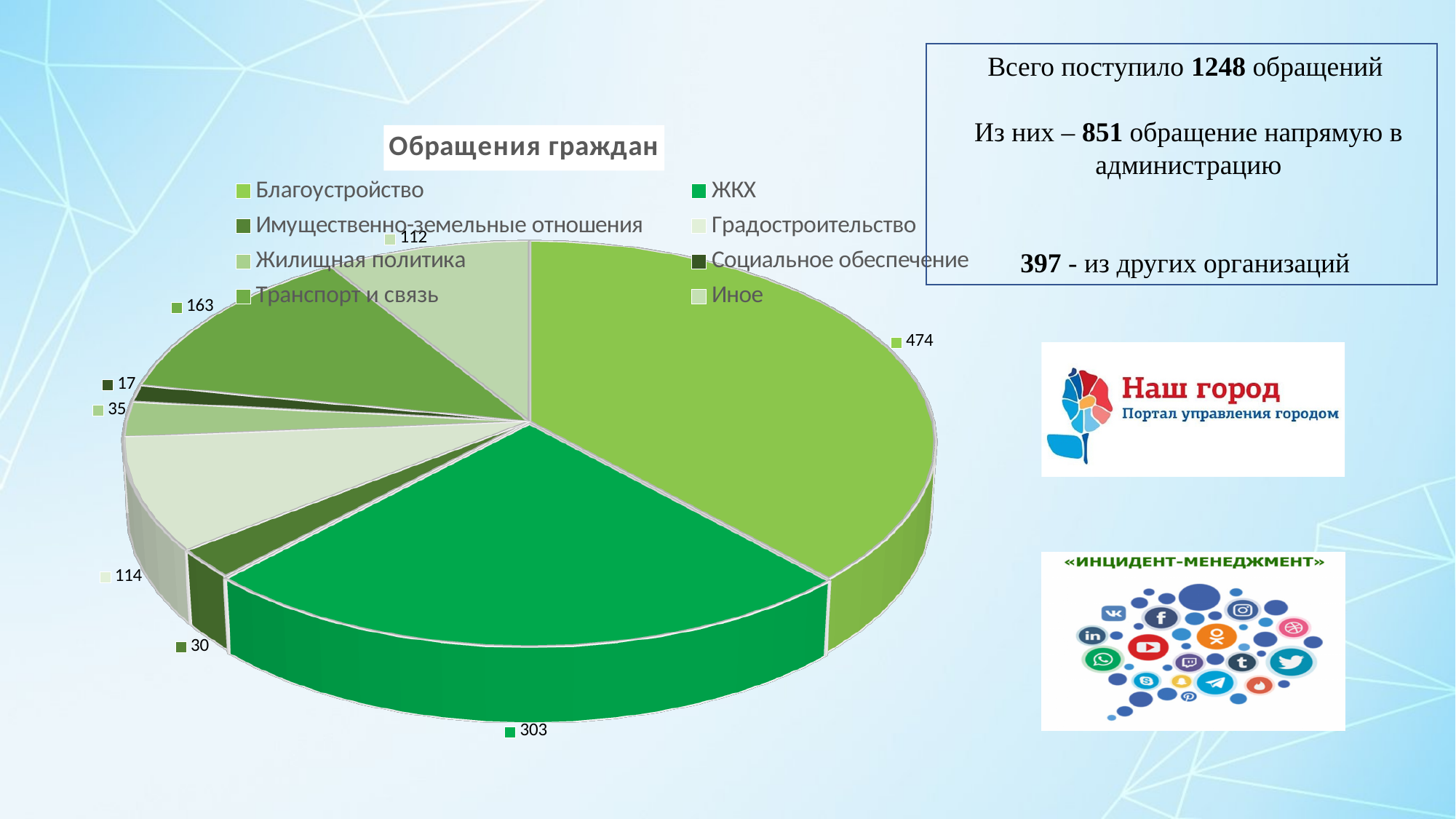
Which category has the smallest slice? Социальное обеспечение What is the title of the chart? Обращения граждан What is the value for Благоустройство? 474 What is the value for Градостроительство? 114 What is the value for ЖКХ? 303 What is the difference between the values for Благоустройство and ЖКХ? 171 What is the value for Транспорт и связь? 163 Which category has the largest slice? Благоустройство Which is larger, the value for Иное or the value for Жилищная политика? Иное How many categories does the pie chart have? 8 What is the value for Социальное обеспечение? 17 What kind of chart is shown on the slide? pie chart